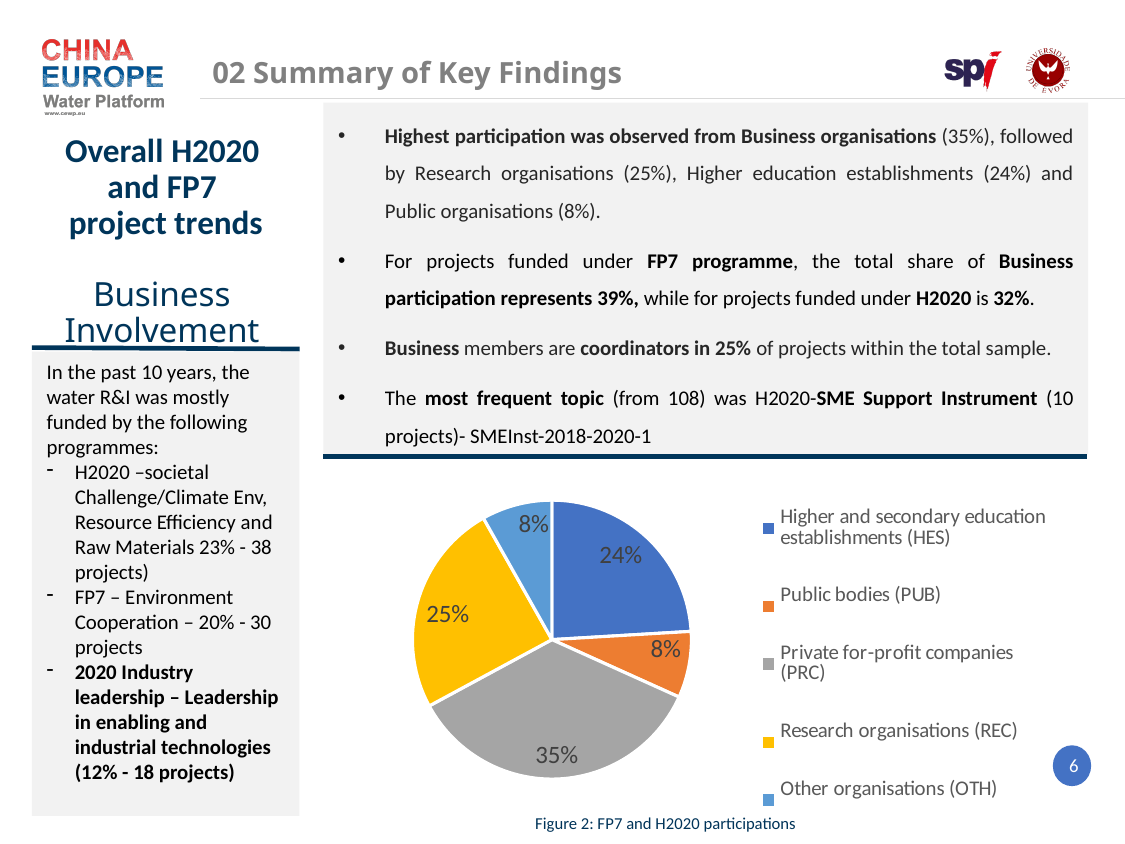
What share of the pie chart is Higher and secondary education establishments (HES)? 24% Which slice is larger: Research organisations (REC) or Higher and secondary education establishments (HES)? Research organisations (REC) What share of the pie chart is Public bodies (PUB)? 8% What is the difference in percentage points between the Private for-profit companies (PRC) slice and the Research organisations (REC) slice? 10 What colour is the Research organisations (REC) slice in the pie chart? yellow What kind of chart is shown on the slide? pie chart What is the combined share of Public bodies (PUB) and Other organisations (OTH)? 16% What is the caption of the pie chart figure? Figure 2: FP7 and H2020 participations What share of the pie chart is Private for-profit companies (PRC)? 35% How many categories does the pie chart's legend list? 5 Which category has the largest slice of the pie chart? Private for-profit companies (PRC) What share of the pie chart is Research organisations (REC)? 25%